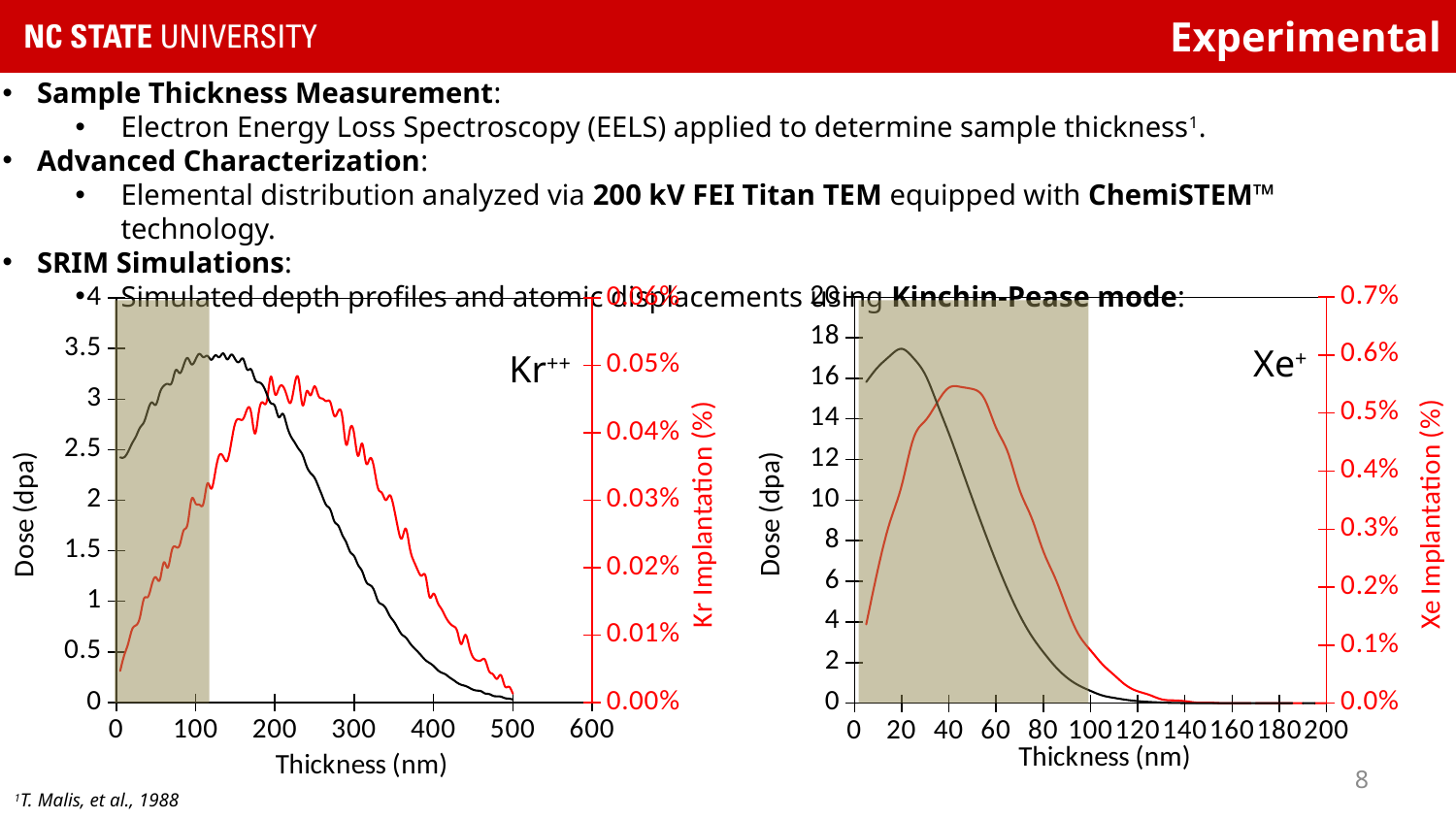
On the Kr++ chart on the left, does the dose rise or fall as thickness increases from 200 nm to 500 nm? fall On the Kr++ chart on the left, is the dose larger at a thickness of 100 nm or at 400 nm? 100 nm On the Xe+ chart on the right, does the dose rise or fall as thickness increases from 20 nm to 100 nm? fall On the Xe+ chart on the right, is the Xe implantation at a thickness of 40 nm greater or less than 0.4%? greater On the Kr++ chart on the left, is the dose at a thickness of 400 nm greater or less than 1 dpa? less On the Kr++ chart on the left, is the dose at a thickness of 100 nm greater or less than 3 dpa? greater What kind of chart is the Kr++ chart on the left of the slide? line chart Which chart reaches a higher peak dose in dpa, the Kr++ chart on the left or the Xe+ chart on the right? Xe+ chart What is the label of the right-hand (secondary) y-axis on the Xe+ chart? Xe Implantation (%)